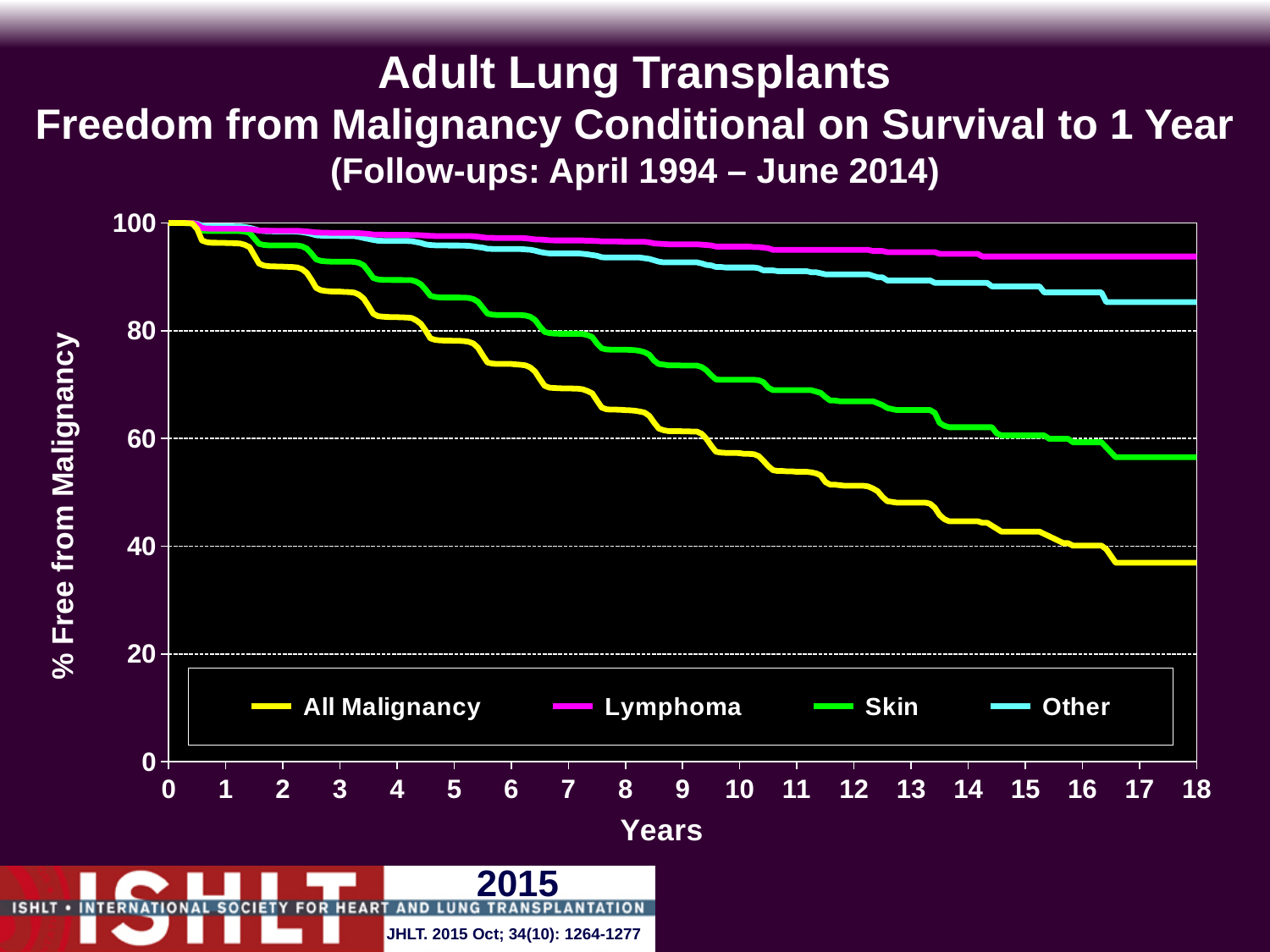
Is the value for Other at 18 years greater or less than 80? greater Is the value for All Malignancy at 18 years greater or less than 40? less How many series does the legend list? 4 What kind of chart is shown on the slide? Line chart Which series has the lowest value at 18 years? All Malignancy What is the label of the y axis? % Free from Malignancy Is the value for All Malignancy at 10 years greater or less than 60? less Does the All Malignancy line rise or fall as years increase? Fall Which series has the highest value at 18 years? Lymphoma At 18 years, which is higher: Lymphoma or Other? Lymphoma What follow-up period is given in the chart title? April 1994 – June 2014